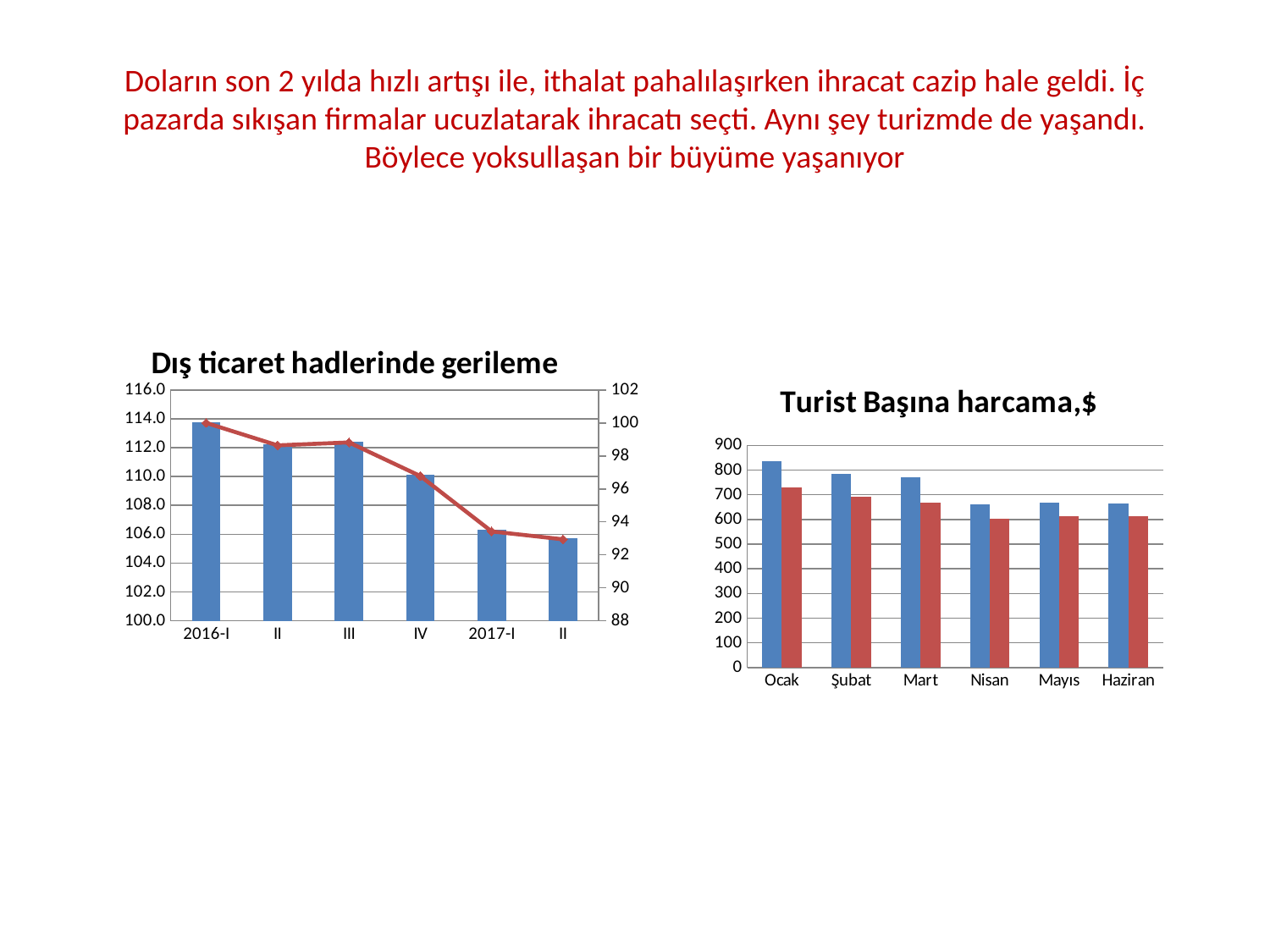
In the chart titled "Turist Başına harcama,$", which month has the highest blue bar? Ocak In the chart titled "Turist Başına harcama,$", is the blue bar for Nisan greater or less than 700? less In the chart titled "Turist Başına harcama,$", is the red bar for Ocak greater or less than 700? greater In the chart titled "Turist Başına harcama,$", is the blue bar for Ocak greater or less than 800? greater In the chart titled "Dış ticaret hadlerinde gerileme", which period has the highest bar? 2016-I In the chart titled "Turist Başına harcama,$", how many months are shown on the x axis? 6 In the chart titled "Dış ticaret hadlerinde gerileme", what colour is the line plotted over the bars? red In the chart titled "Turist Başına harcama,$", what kind of chart is it? bar chart In the chart titled "Turist Başına harcama,$", which is larger, the red bar for Mart or the red bar for Nisan? Mart In the chart titled "Dış ticaret hadlerinde gerileme", how many periods are shown on the x axis? 6 In the chart titled "Dış ticaret hadlerinde gerileme", do the bar values rise or fall from 2016-I to 2017-II? fall